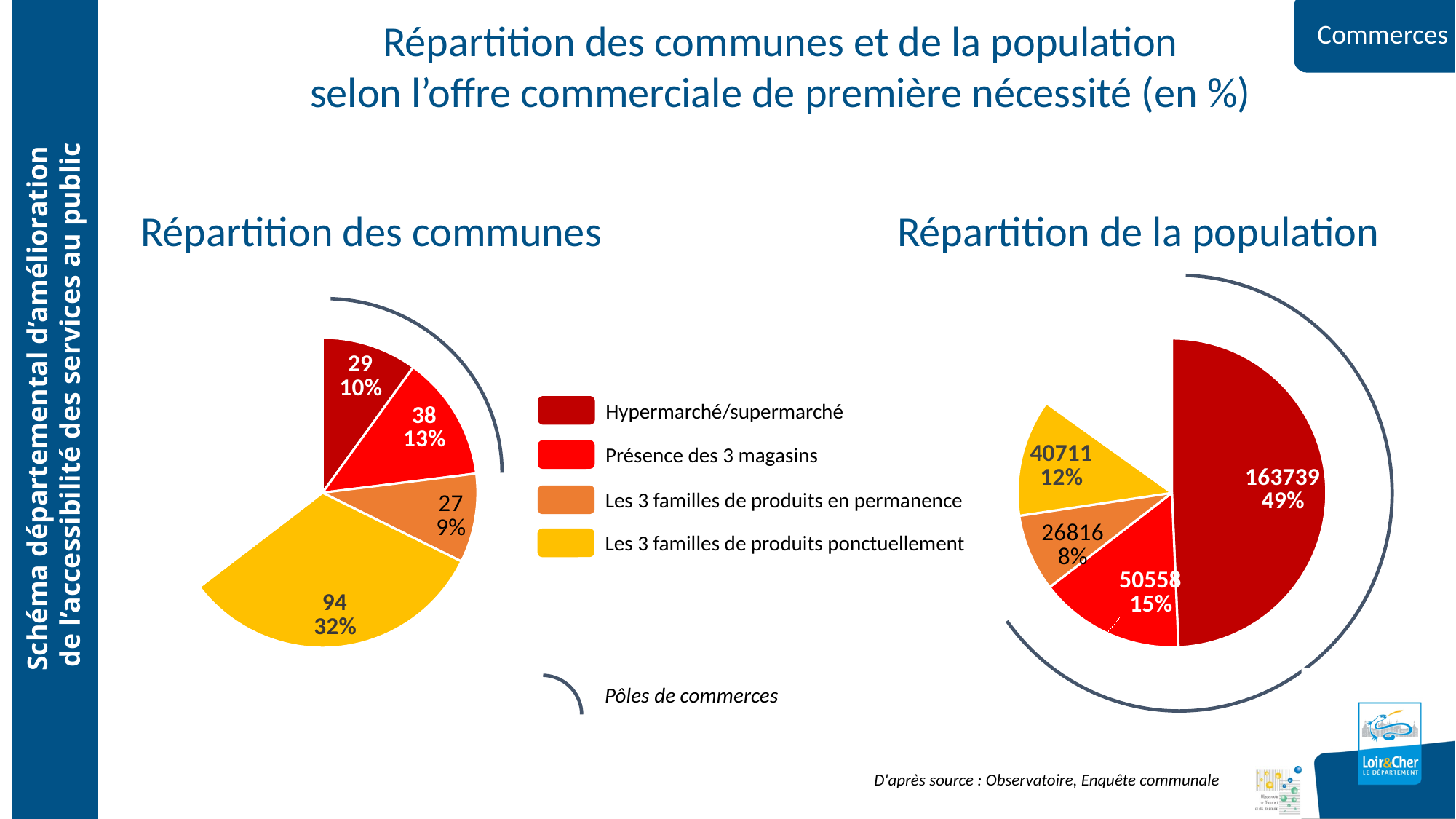
In the 'Répartition de la population' chart, which category has the largest share? Hypermarché/supermarché In the 'Répartition des communes' chart, what is the difference between the number of communes for 'Présence des 3 magasins' and 'Hypermarché/supermarché'? 9 In the 'Répartition de la population' chart, what is the population value for 'Hypermarché/supermarché'? 163739 Which colour represents 'Les 3 familles de produits ponctuellement' in the legend? yellow In the 'Répartition de la population' chart, what percentage is shown for 'Les 3 familles de produits en permanence'? 8% In the 'Répartition de la population' chart, which is larger: the population for 'Présence des 3 magasins' or for 'Les 3 familles de produits ponctuellement'? Présence des 3 magasins In the 'Répartition des communes' chart, which category has the smallest slice? Les 3 familles de produits en permanence How many slices does the 'Répartition de la population' pie chart have? 4 In the 'Répartition des communes' chart, what percentage is shown for 'Les 3 familles de produits ponctuellement'? 32% How many categories does the shared legend list? 4 In the 'Répartition des communes' chart, how many communes are in the 'Hypermarché/supermarché' category? 29 What type of chart is used for 'Répartition des communes'? pie chart